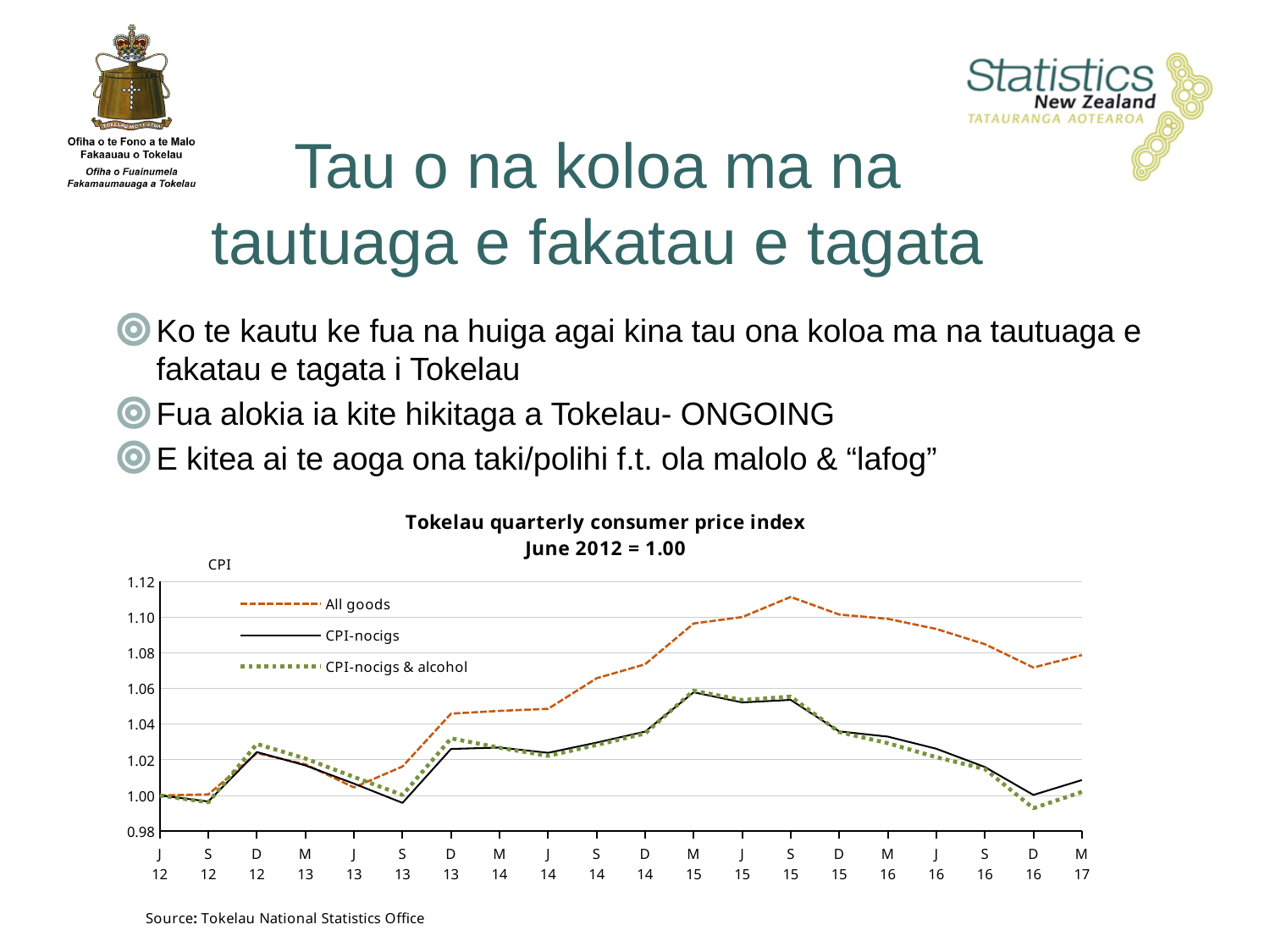
How many series does the chart legend list? 3 What is the title of the chart? Tokelau quarterly consumer price index June 2012 = 1.00 What kind of chart is shown on the slide? line chart Does the All goods series rise or fall between S 15 and D 16? fall At S 15, which series has the larger value: All goods or CPI-nocigs? All goods Is the CPI-nocigs value for M 15 greater or less than 1.04? greater Is the CPI-nocigs & alcohol value for D 16 greater or less than 1.00? less Is the All goods value for S 15 greater or less than 1.10? greater What source is cited below the chart? Tokelau National Statistics Office How many quarterly points are plotted along the x axis of the chart? 20 In which quarter does the All goods series reach its highest value? S 15